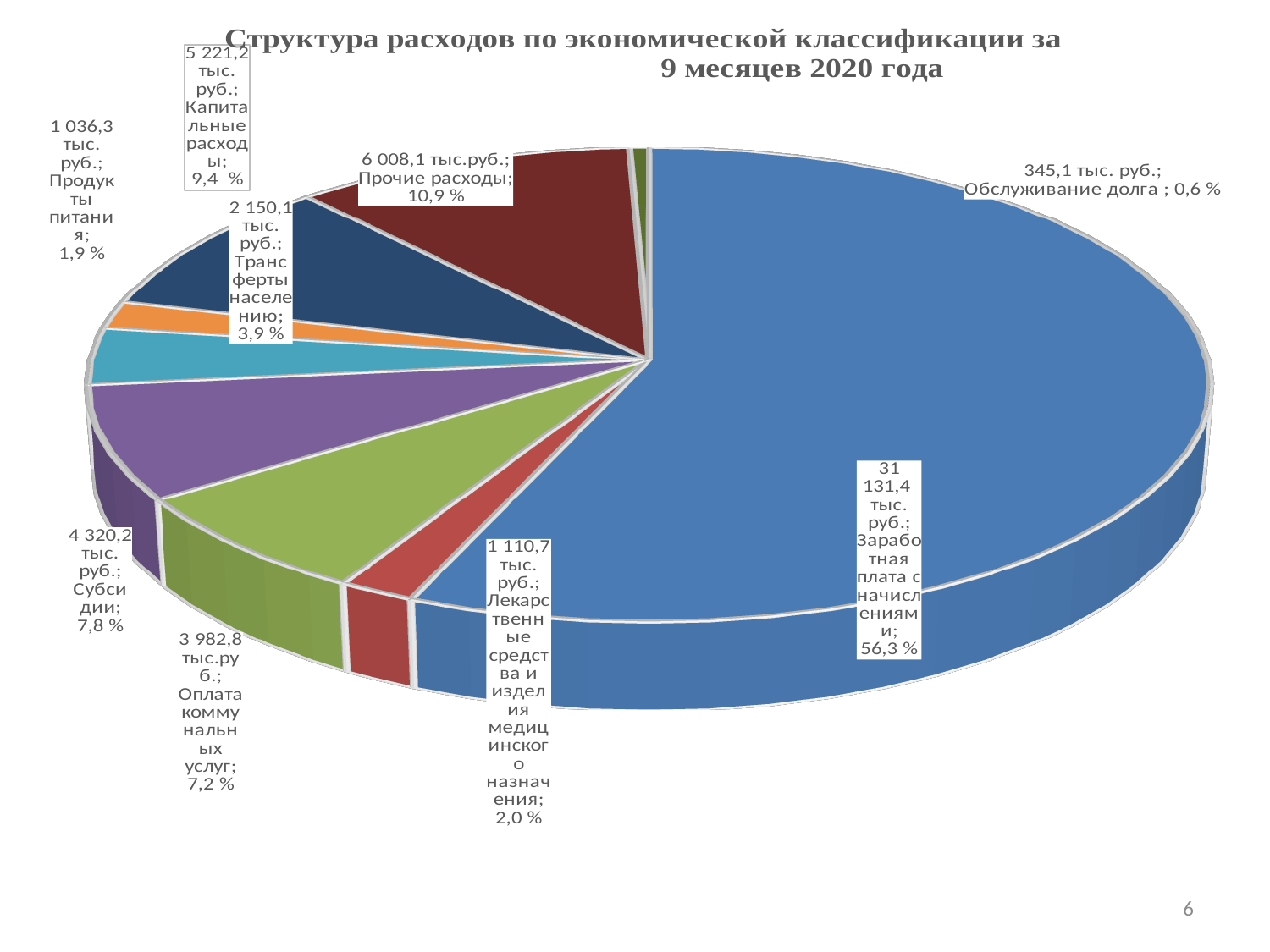
What is the difference in percentage share between Прочие расходы and Капитальные расходы? 1,5 % What is the value for Прочие расходы? 6 008,1 тыс.руб. Which category has the largest share of the pie? Заработная плата с начислениями Which category has the smallest share of the pie? Обслуживание долга What is the value for Обслуживание долга? 345,1 тыс. руб. How many slices does the pie chart have? 9 What share of the pie does Капитальные расходы take? 9,4 % What share of the pie does Заработная плата с начислениями take? 56,3 % What is the value for Заработная плата с начислениями? 31 131,4 тыс. руб. What kind of chart is shown on the slide? pie chart Which is larger, Субсидии or Оплата коммунальных услуг? Субсидии What is the title of the chart? Структура расходов по экономической классификации за 9 месяцев 2020 года